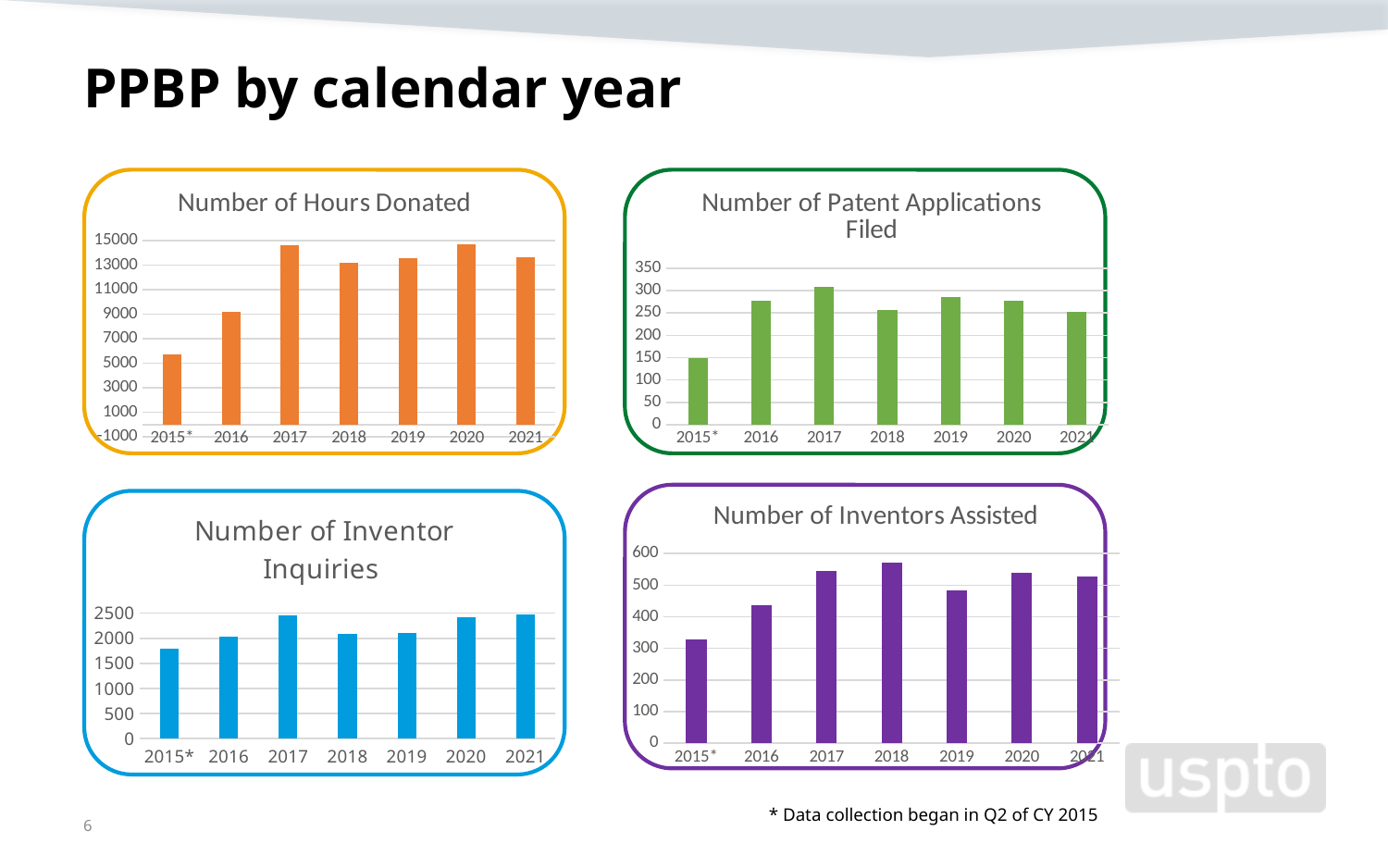
In the Number of Inventor Inquiries chart, which year has the lowest value? 2015* In the Number of Patent Applications Filed chart, which year has the highest value? 2017 In the Number of Hours Donated chart, which is larger, the value for 2016 or the value for 2017? 2017 In the Number of Patent Applications Filed chart, is the value for 2015* greater or less than 200? less In the Number of Patent Applications Filed chart, which year has the lowest value? 2015* In the Number of Hours Donated chart, which year has the lowest value? 2015* In the Number of Inventors Assisted chart, which year has the highest value? 2018 In the Number of Hours Donated chart, is the value for 2016 greater or less than 7000? greater How many years are shown on the x axis of the Number of Inventors Assisted chart? 7 What kind of chart is the Number of Hours Donated chart? bar chart In the Number of Inventors Assisted chart, is the value for 2019 greater or less than 500? less